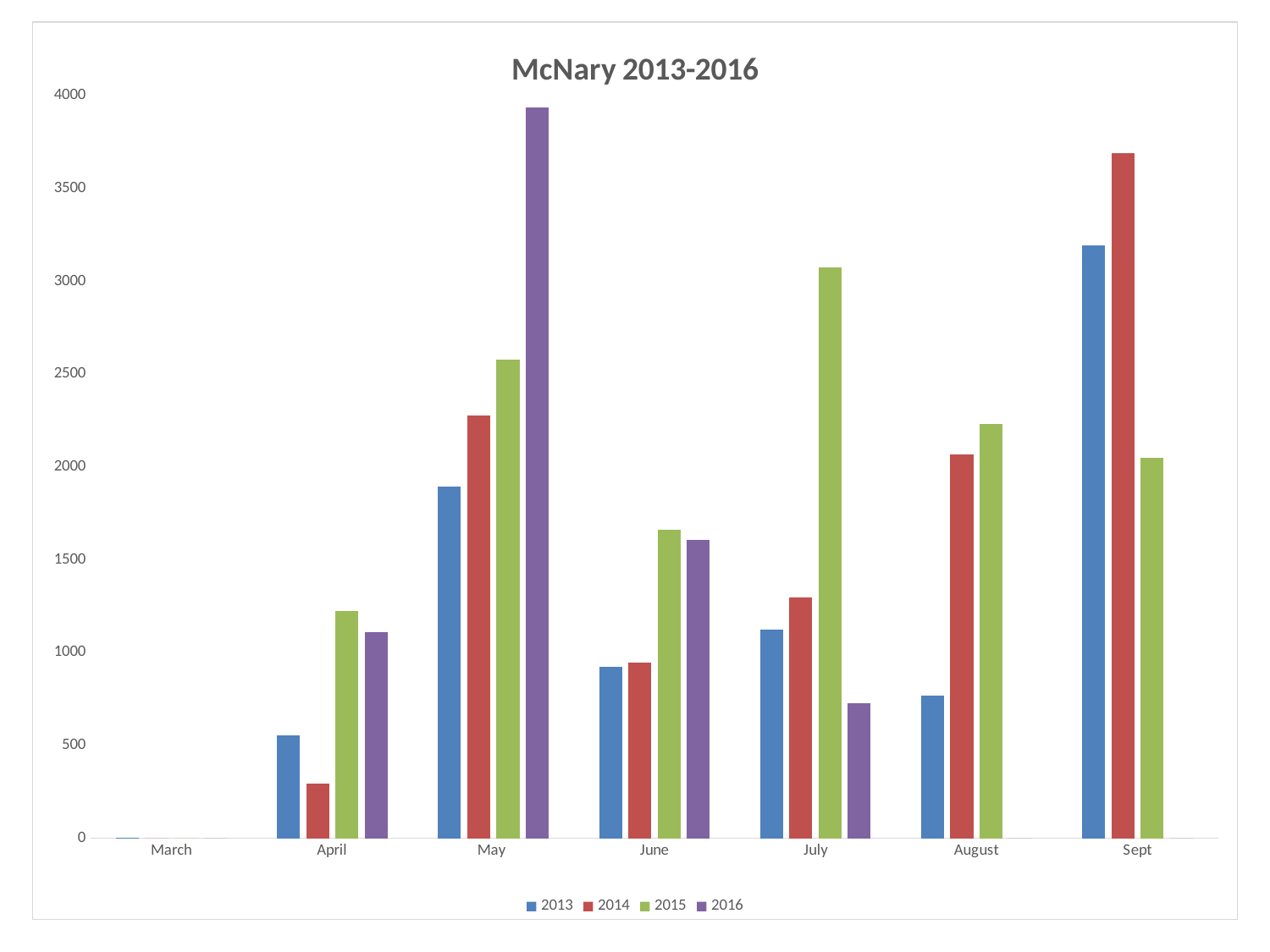
Is the value for 2013 in August greater or less than 1000? less In which month is the 2016 value highest? May In April, which is larger: the 2013 value or the 2014 value? 2013 In which month is the 2013 value lowest? March What is the title of the chart? McNary 2013-2016 Is the value for 2016 in May greater or less than 3500? greater What kind of chart is shown on the slide? bar chart In which month is the 2014 value highest? Sept How many series does the legend list? 4 In which month is the 2015 value highest? July How many month categories are shown on the x axis? 7 Is the value for 2015 in July greater or less than 2500? greater